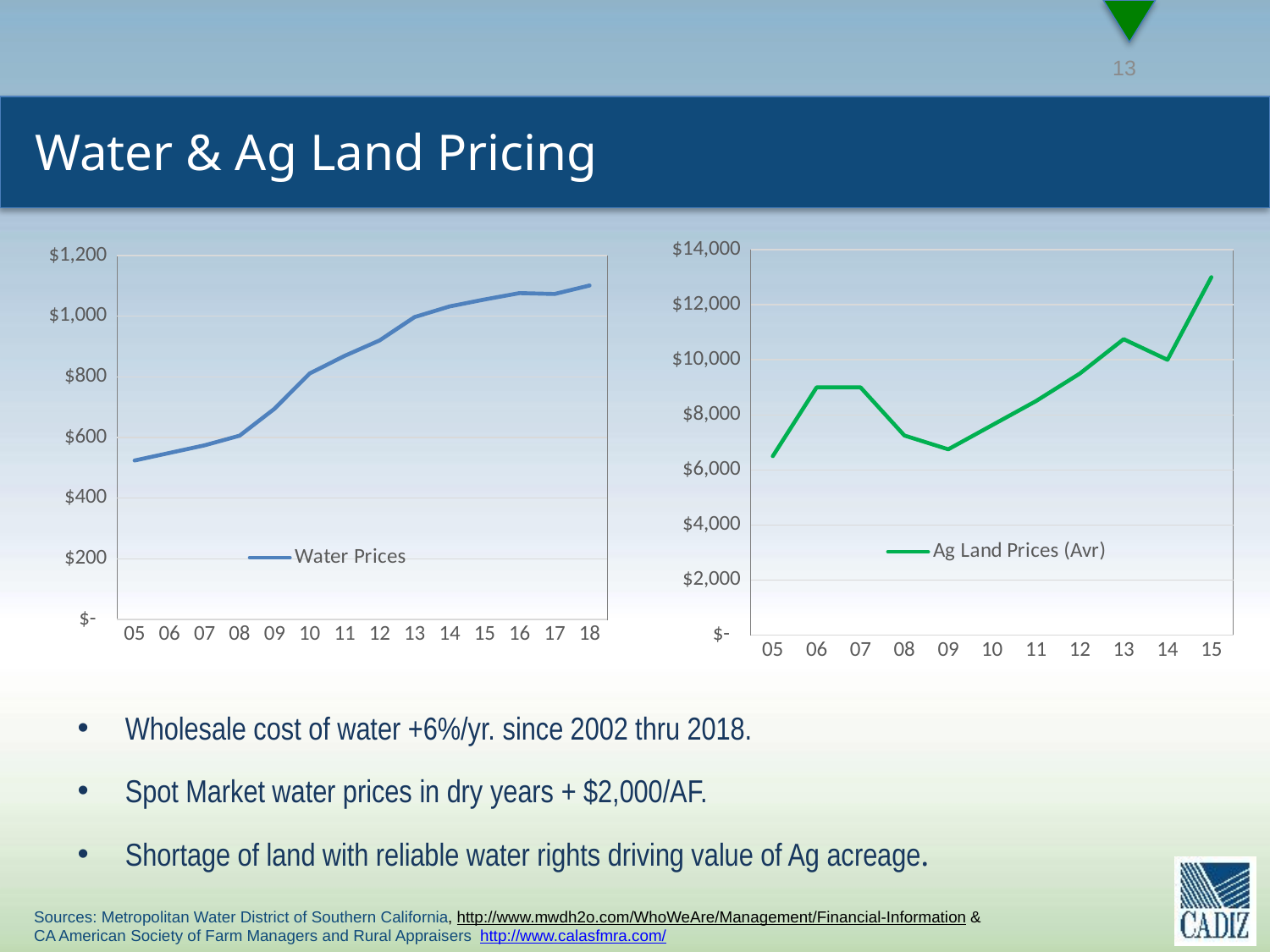
In the Water Prices chart, do the values generally rise or fall from 05 to 18? rise In the Ag Land Prices (Avr) chart, which year has the highest value? 15 How many years are plotted on the x axis of the Water Prices chart? 14 How many series does the legend of the Water Prices chart list? 1 In the Ag Land Prices (Avr) chart, which is larger, the value for 13 or the value for 14? 13 What kind of chart is the Ag Land Prices (Avr) chart on the right? line chart In the Ag Land Prices (Avr) chart, is the value for 09 greater or less than $8,000? less In the Water Prices chart, which year has the lowest value? 05 How many years are plotted on the x axis of the Ag Land Prices (Avr) chart? 11 In the Water Prices chart, is the value for 05 greater or less than $600? less In the Water Prices chart, which year has the highest value? 18 What kind of chart is the Water Prices chart on the left? line chart